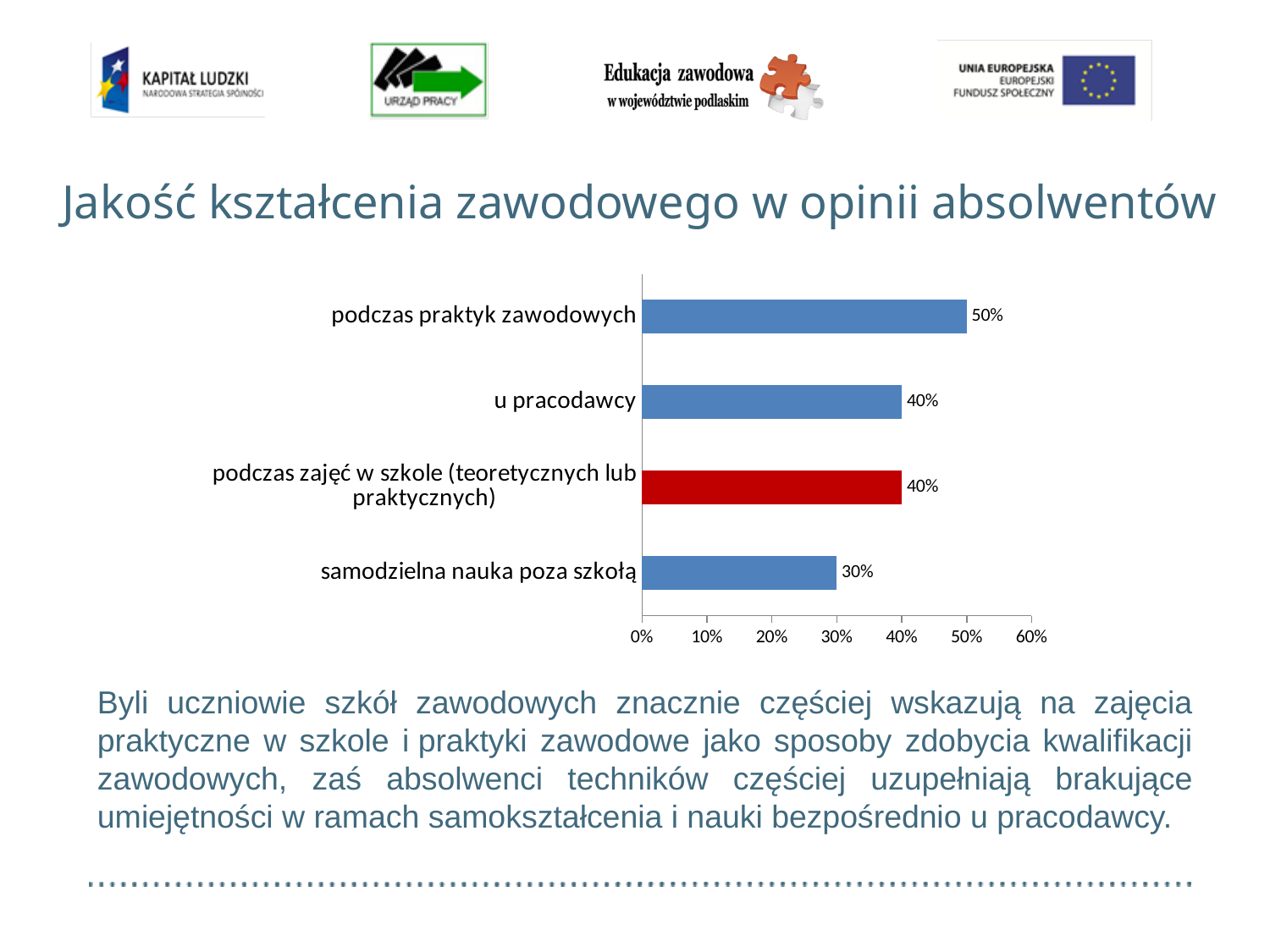
How many categories are shown in the chart? 4 Which category has the highest value? podczas praktyk zawodowych What is the value for "u pracodawcy"? 40% What is the value for "samodzielna nauka poza szkołą"? 30% What kind of chart is shown on the slide? bar chart What is the highest value shown on the x axis? 60% Which category has the lowest value? samodzielna nauka poza szkołą What is the difference between the values for "podczas praktyk zawodowych" and "samodzielna nauka poza szkołą"? 20% Which is larger: the value for "u pracodawcy" or the value for "samodzielna nauka poza szkołą"? u pracodawcy What is the value for "podczas praktyk zawodowych"? 50% What is the value for "podczas zajęć w szkole (teoretycznych lub praktycznych)"? 40% Which category's bar is coloured red rather than blue? podczas zajęć w szkole (teoretycznych lub praktycznych)